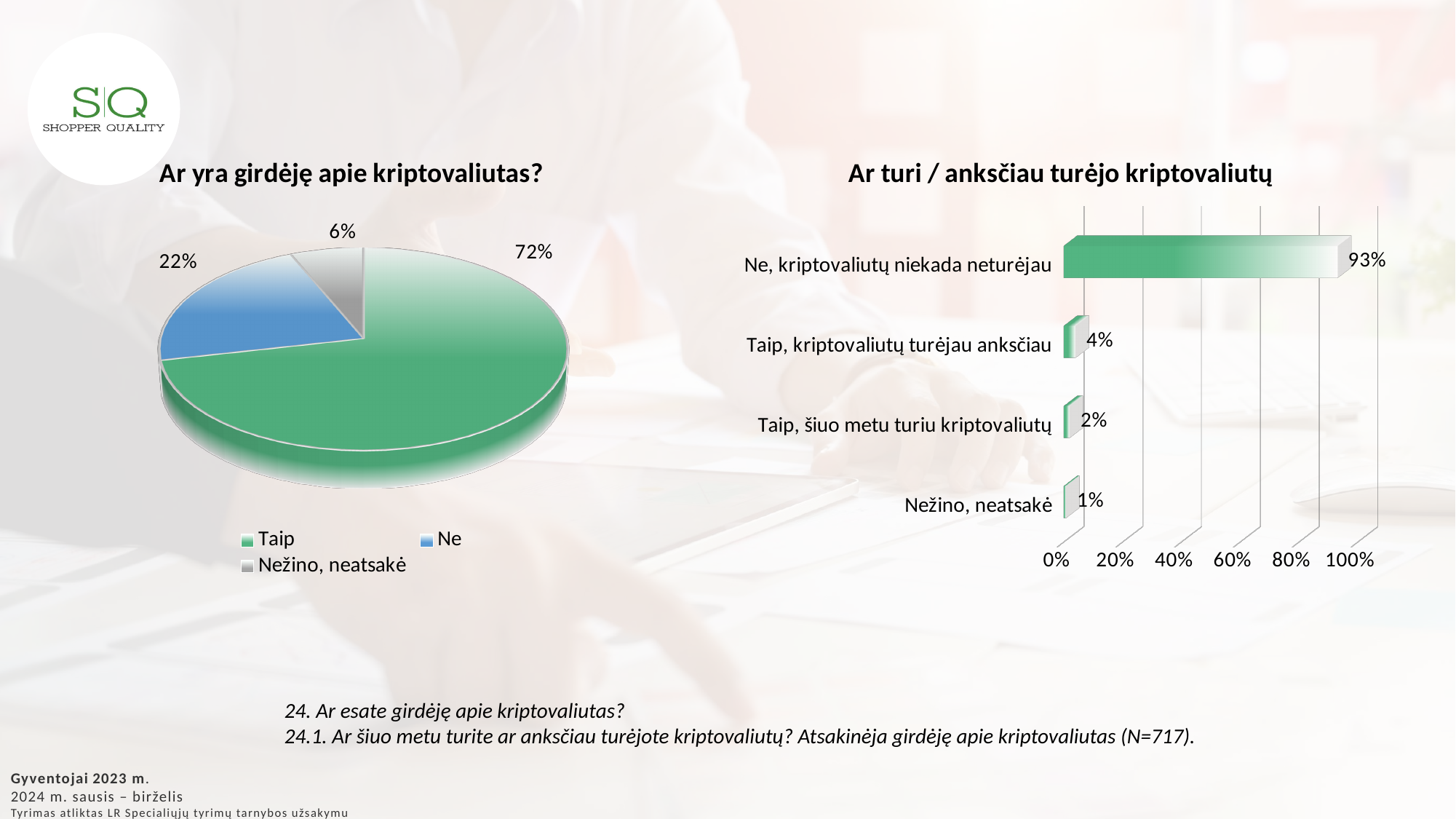
In the bar chart 'Ar turi / anksčiau turėjo kriptovaliutų', what is the value for 'Taip, šiuo metu turiu kriptovaliutų'? 2% In the bar chart 'Ar turi / anksčiau turėjo kriptovaliutų', what is the value for 'Taip, kriptovaliutų turėjau anksčiau'? 4% In the bar chart 'Ar turi / anksčiau turėjo kriptovaliutų', how many categories are shown? 4 In the bar chart 'Ar turi / anksčiau turėjo kriptovaliutų', what is the value for 'Ne, kriptovaliutų niekada neturėjau'? 93% In the pie chart 'Ar yra girdėję apie kriptovaliutas?', what share is labelled for 'Nežino, neatsakė'? 6% In the pie chart 'Ar yra girdėję apie kriptovaliutas?', which slice is the largest? Taip What kind of chart is the one on the right titled 'Ar turi / anksčiau turėjo kriptovaliutų'? Bar chart In the pie chart 'Ar yra girdėję apie kriptovaliutas?', what is the difference in percentage points between 'Taip' and 'Ne'? 50 In the pie chart 'Ar yra girdėję apie kriptovaliutas?', what share is labelled for 'Ne'? 22% In the pie chart 'Ar yra girdėję apie kriptovaliutas?', how many slices does the pie have? 3 In the bar chart 'Ar turi / anksčiau turėjo kriptovaliutų', which category has the lowest value? Nežino, neatsakė In the pie chart 'Ar yra girdėję apie kriptovaliutas?', what share is labelled for 'Taip'? 72%